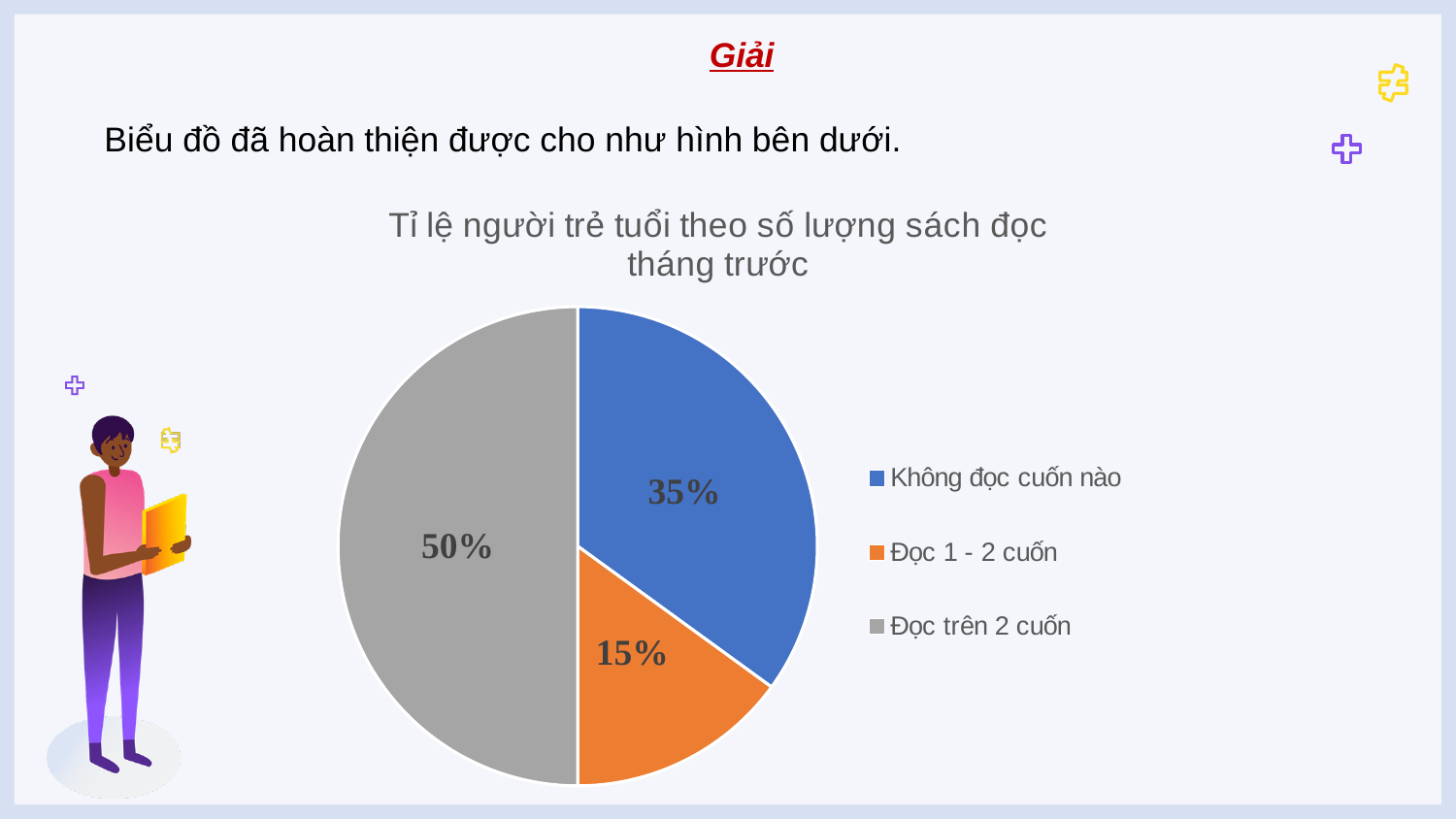
What is the title of the chart? Tỉ lệ người trẻ tuổi theo số lượng sách đọc tháng trước What is the combined share of "Không đọc cuốn nào" and "Đọc 1 - 2 cuốn"? 50% What percentage of the pie is labelled "Đọc trên 2 cuốn"? 50% How many categories does the pie chart have? 3 What kind of chart is shown on the slide? pie chart What percentage of the pie is labelled "Đọc 1 - 2 cuốn"? 15% What is the difference in percentage points between "Đọc trên 2 cuốn" and "Không đọc cuốn nào"? 15% Which category has the smallest share of the pie? Đọc 1 - 2 cuốn Which is larger: the share for "Không đọc cuốn nào" or the share for "Đọc 1 - 2 cuốn"? Không đọc cuốn nào What colour is the slice for "Đọc 1 - 2 cuốn"? orange What percentage of the pie is labelled "Không đọc cuốn nào"? 35% Which category has the largest share of the pie? Đọc trên 2 cuốn